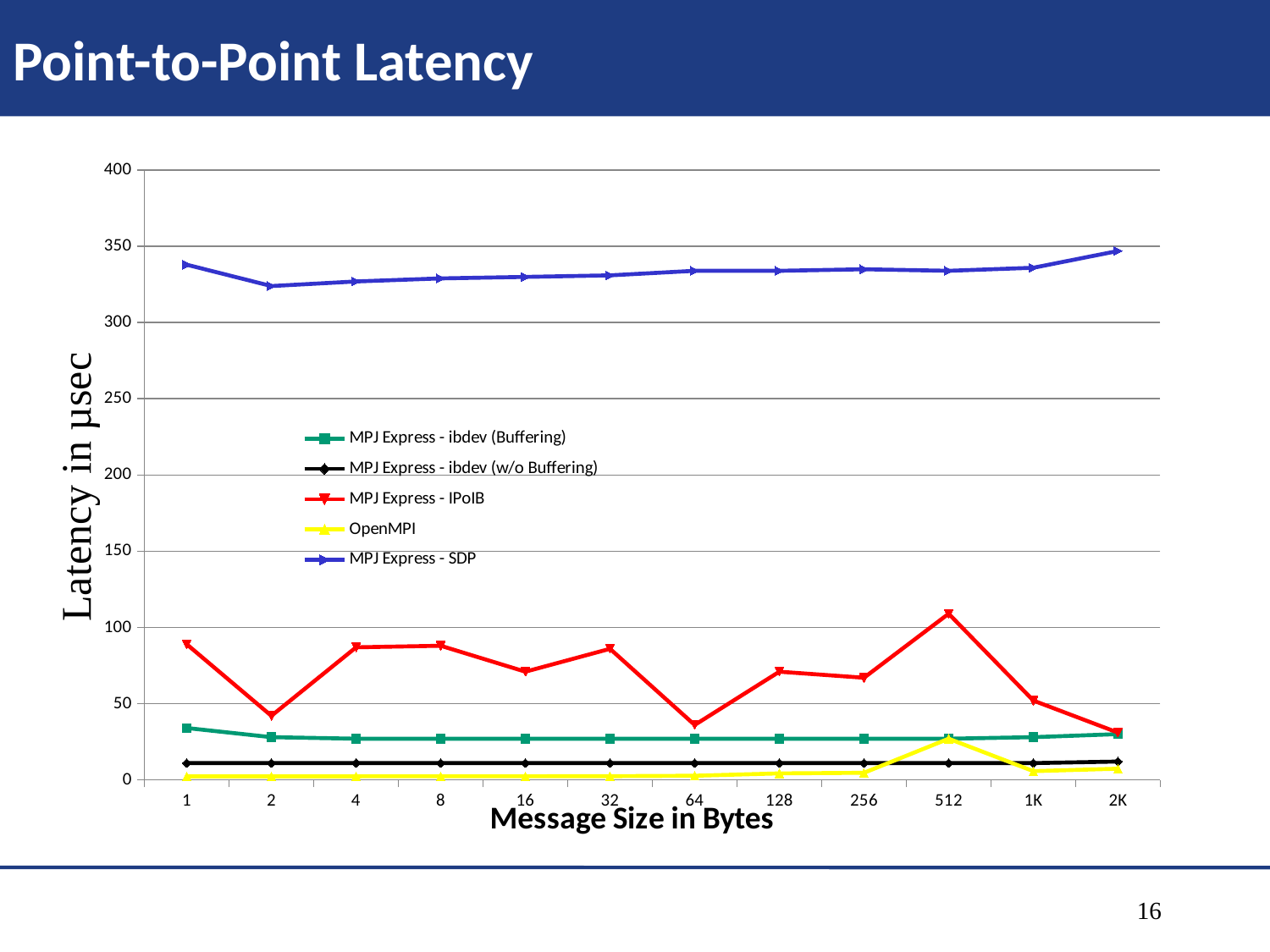
What is the label of the y axis? Latency in μsec At message size 512, which has the higher latency: MPJ Express - IPoIB or MPJ Express - ibdev (Buffering)? MPJ Express - IPoIB Which series has the highest latency across all message sizes? MPJ Express - SDP Is the latency for MPJ Express - SDP at message size 1 greater or less than 300? greater At which message size does MPJ Express - IPoIB reach its highest latency? 512 What kind of chart is shown on the slide? Line chart Is the latency for MPJ Express - IPoIB at message size 512 greater or less than 100? greater Which series has the lowest latency for message sizes 1 through 256? OpenMPI At which message size is the MPJ Express - SDP latency lowest? 2 Is the latency for MPJ Express - ibdev (Buffering) at message size 1 greater or less than 50? less How many message sizes are plotted along the x axis? 12 How many series does the legend list? 5